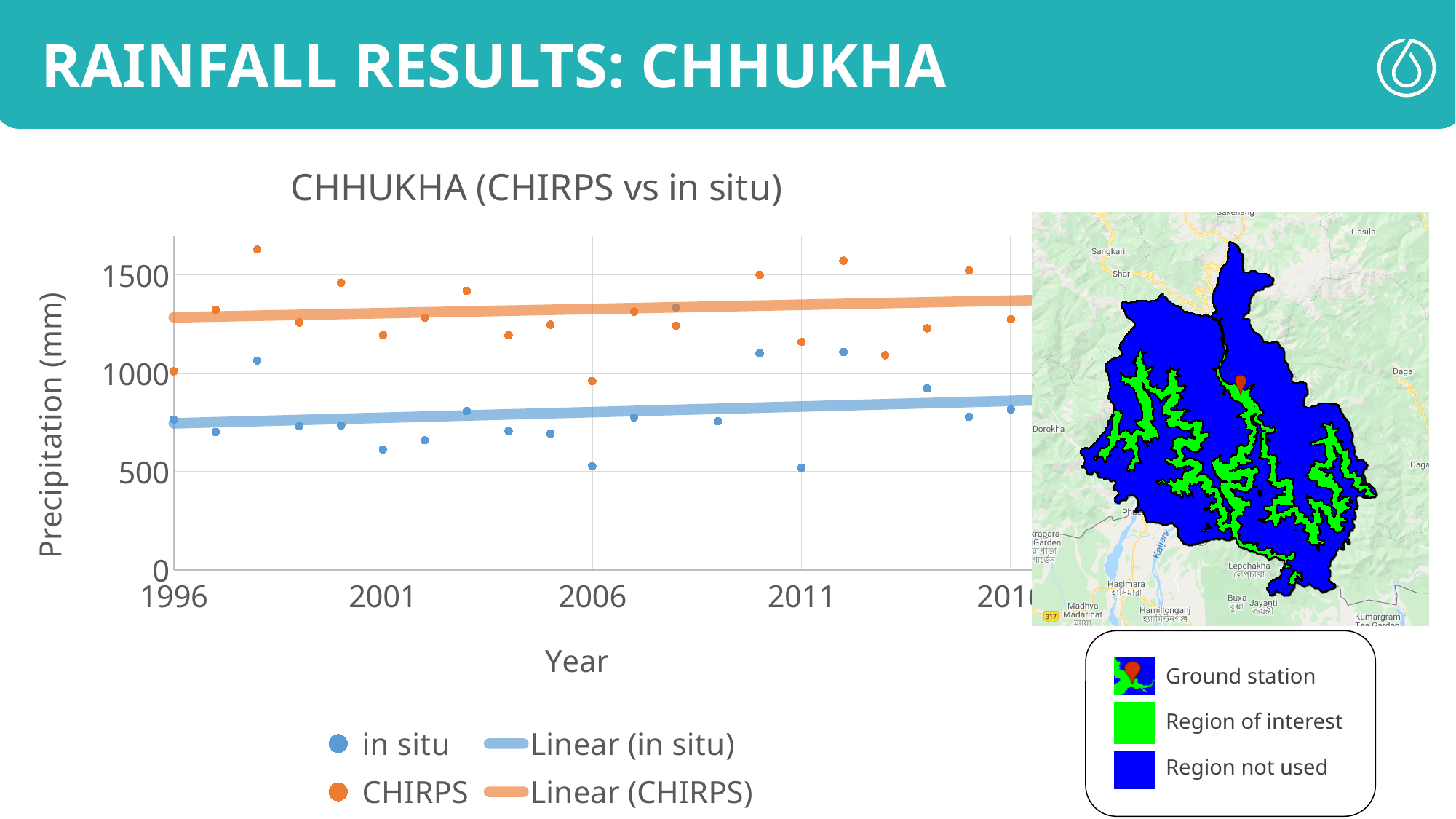
Which trend line lies higher on the chart, Linear (CHIRPS) or Linear (in situ)? Linear (CHIRPS) Does the Linear (in situ) trend line rise or fall from 1996 to 2016? rise What is the label of the y axis? Precipitation (mm) Is the in situ value for 2016 greater or less than 1000? less What kind of chart is shown on the slide? scatter chart How many entries does the chart legend list? 4 Is the CHIRPS value for 1998 greater or less than 1500? greater Is the in situ value for 1996 greater or less than 1000? less Does the Linear (CHIRPS) trend line rise or fall from 1996 to 2016? rise What is the title of the chart? CHHUKHA (CHIRPS vs in situ)